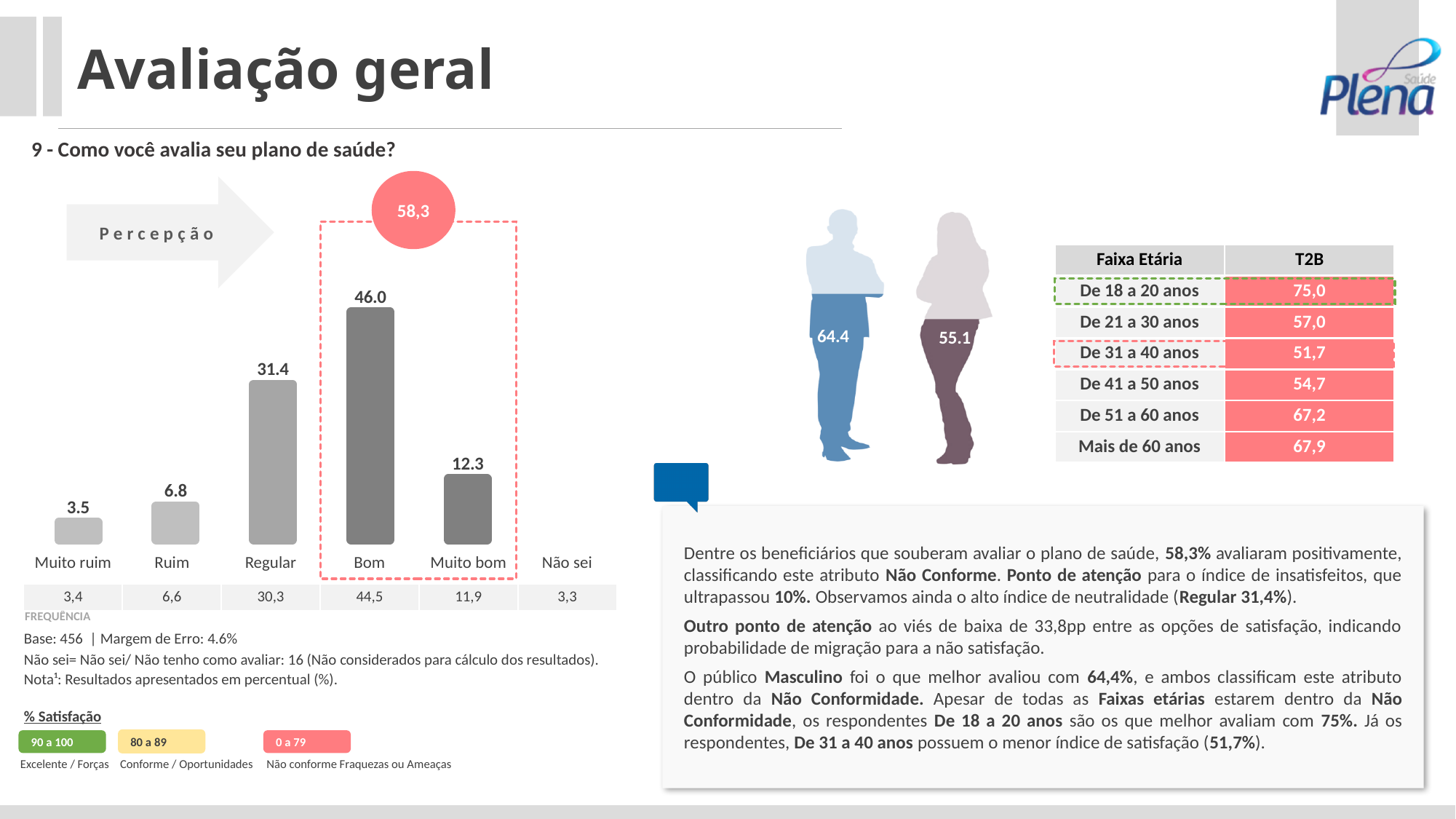
What is the value shown for 'Regular' in the bar chart? 31.4 What kind of chart is used to show the answers to 'Como você avalia seu plano de saúde?' bar chart What is the difference between the values for 'Muito bom' and 'Ruim' in the bar chart? 5.5 Which category has the highest bar in the chart? Bom What is the value shown for 'Bom' in the bar chart? 46.0 How many bars are plotted in the bar chart? 5 Which is larger in the bar chart, the value for 'Muito bom' or the value for 'Ruim'? Muito bom What is the difference between the values for 'Bom' and 'Regular' in the bar chart? 14.6 What value is shown in the red circle above the dashed box around 'Bom' and 'Muito bom'? 58,3 Which category has the lowest bar in the chart? Muito ruim Do the bar values rise or fall from 'Muito ruim' to 'Bom' along the x axis? rise What is the value shown for 'Muito ruim' in the bar chart? 3.5